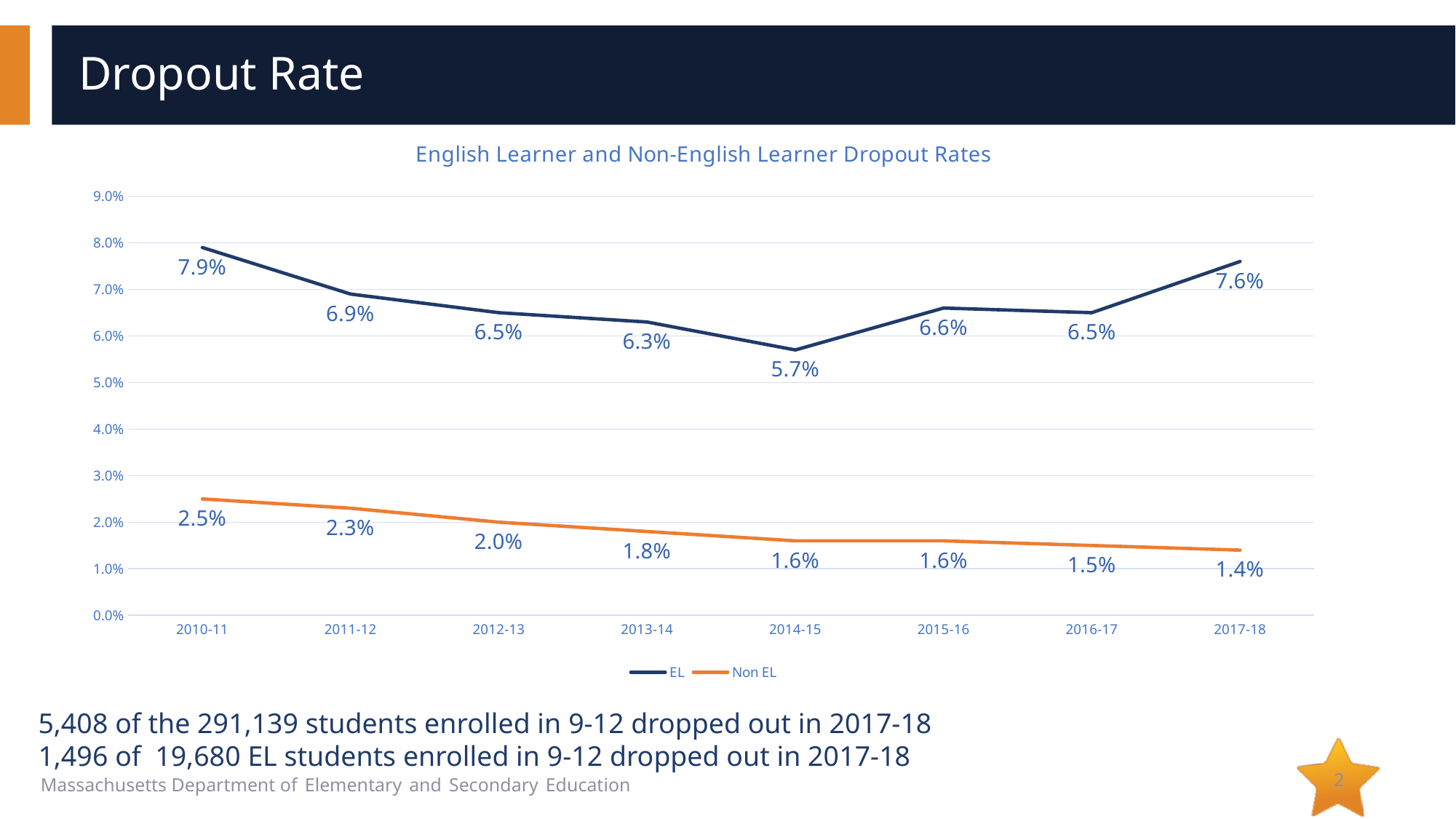
Does the Non EL dropout rate rise or fall from 2010-11 to 2017-18? Fall Which series has the higher dropout rate in 2013-14, EL or Non EL? EL How many school years are shown on the x axis? 8 What kind of chart is shown on the slide? Line chart In which year is the EL dropout rate lowest? 2014-15 What is the EL dropout rate for 2014-15? 5.7% How many series does the legend list? 2 What is the difference between the EL and Non EL dropout rates in 2017-18? 6.2% What is the EL dropout rate for 2010-11? 7.9% In which year is the Non EL dropout rate highest? 2010-11 What is the title of the chart? English Learner and Non-English Learner Dropout Rates What is the Non EL dropout rate for 2017-18? 1.4%